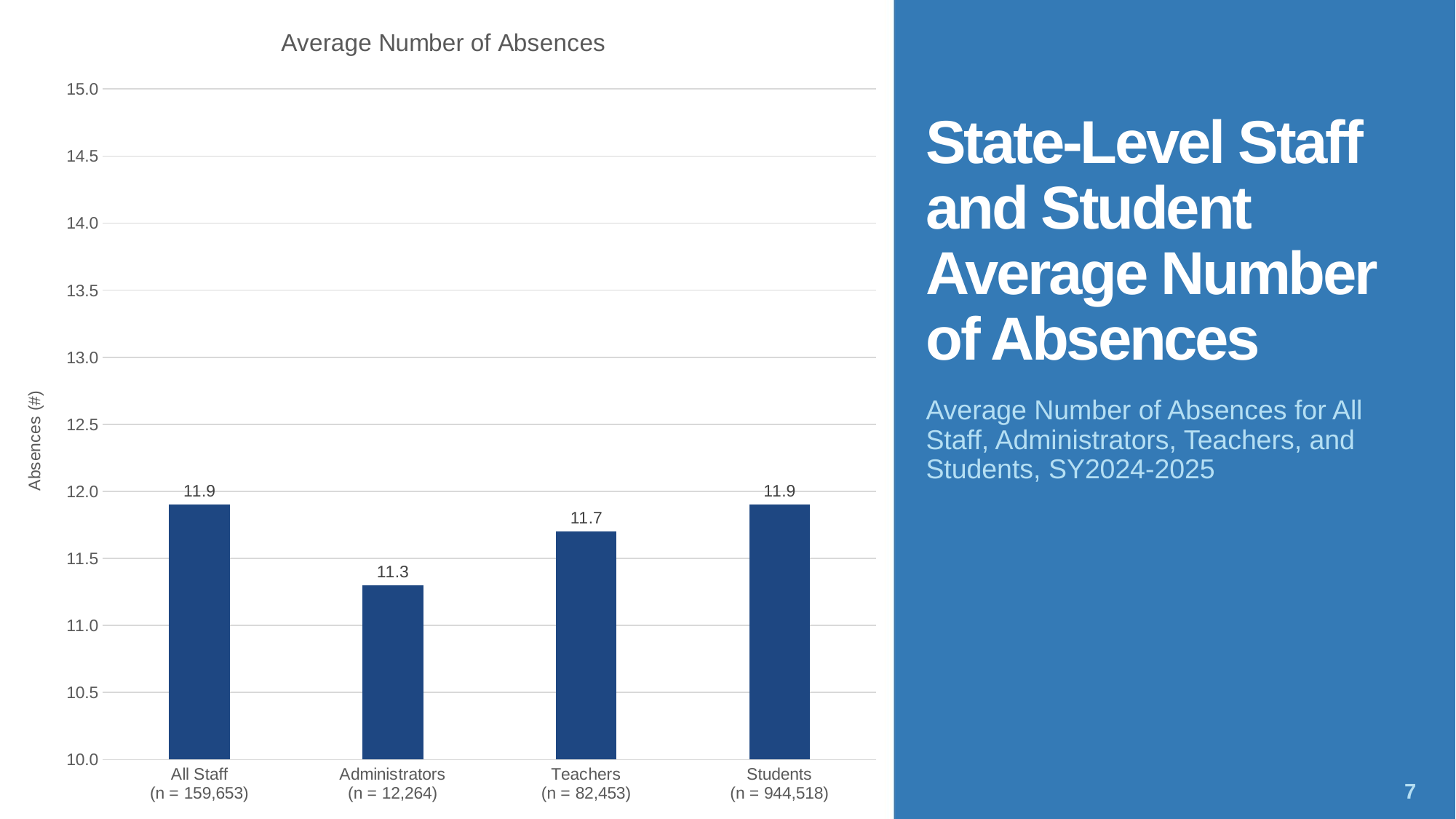
What is the difference between the average number of absences for Teachers and Administrators? 0.4 What is the average number of absences for Administrators? 11.3 What is the average number of absences for Students? 11.9 What is the average number of absences for Teachers? 11.7 How many categories are shown in the chart? 4 Which has a higher average number of absences, Teachers or Administrators? Teachers What is the difference between the average number of absences for All Staff and Administrators? 0.6 Is the value for Administrators greater or less than 11.5? less Which category has the lowest average number of absences? Administrators What kind of chart is shown on the slide? Bar chart What is the title of the chart? Average Number of Absences What is the label of the y axis? Absences (#)